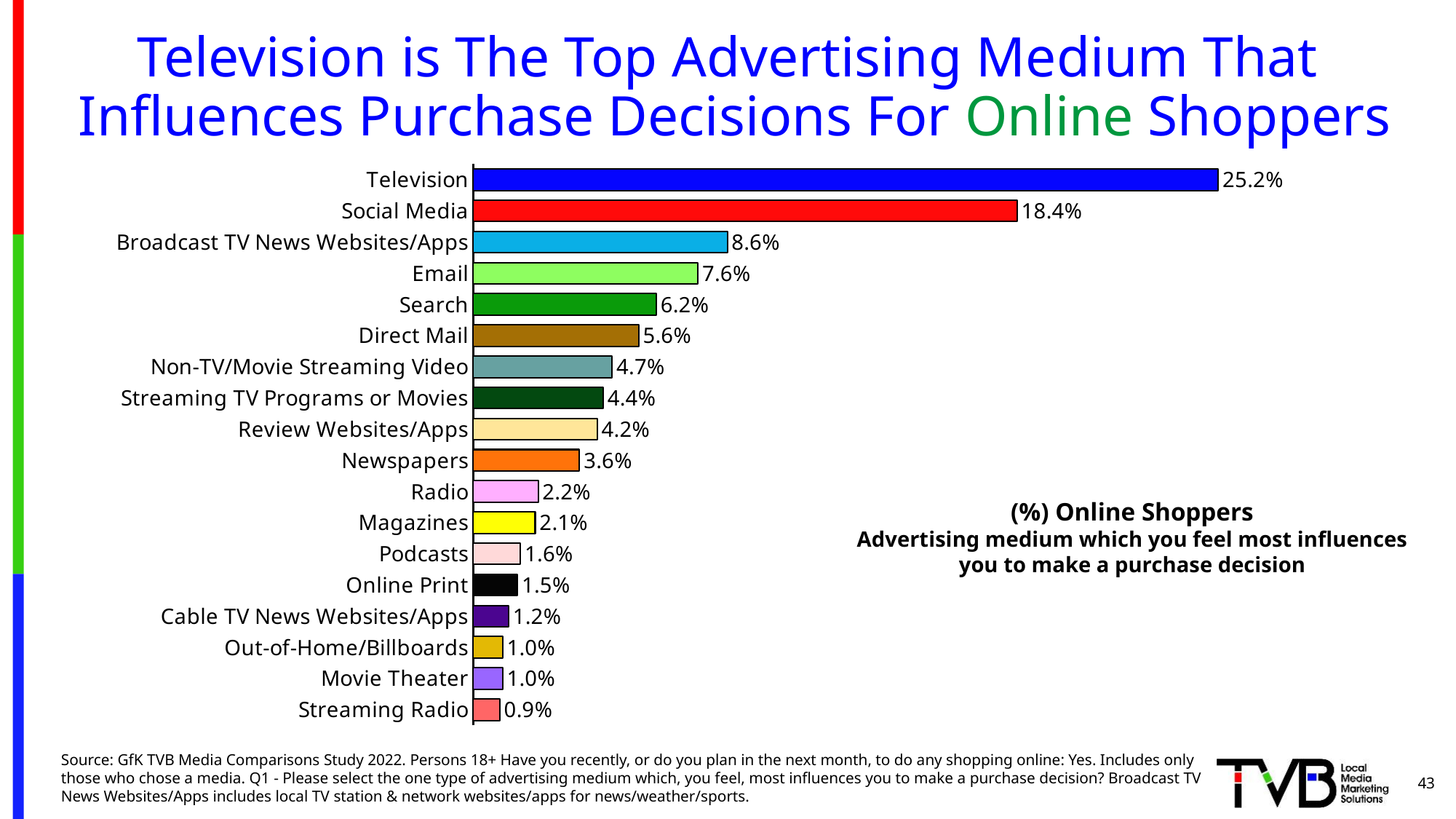
What percentage of online shoppers chose Television as the advertising medium that most influences their purchase decision? 25.2% What is the difference between the values for Email and Search? 1.4% Which has a larger value, Direct Mail or Newspapers? Direct Mail Which advertising medium has the lowest value on the chart? Streaming Radio What is the value shown for Social Media? 18.4% What is the difference between the values for Television and Social Media? 6.8% What colour is the bar for Social Media? Red What type of chart is shown on the slide? Bar chart How many advertising media categories are shown on the chart? 18 What is the value shown for Broadcast TV News Websites/Apps? 8.6% What is the value shown for Podcasts? 1.6% Which advertising medium has the highest value on the chart? Television